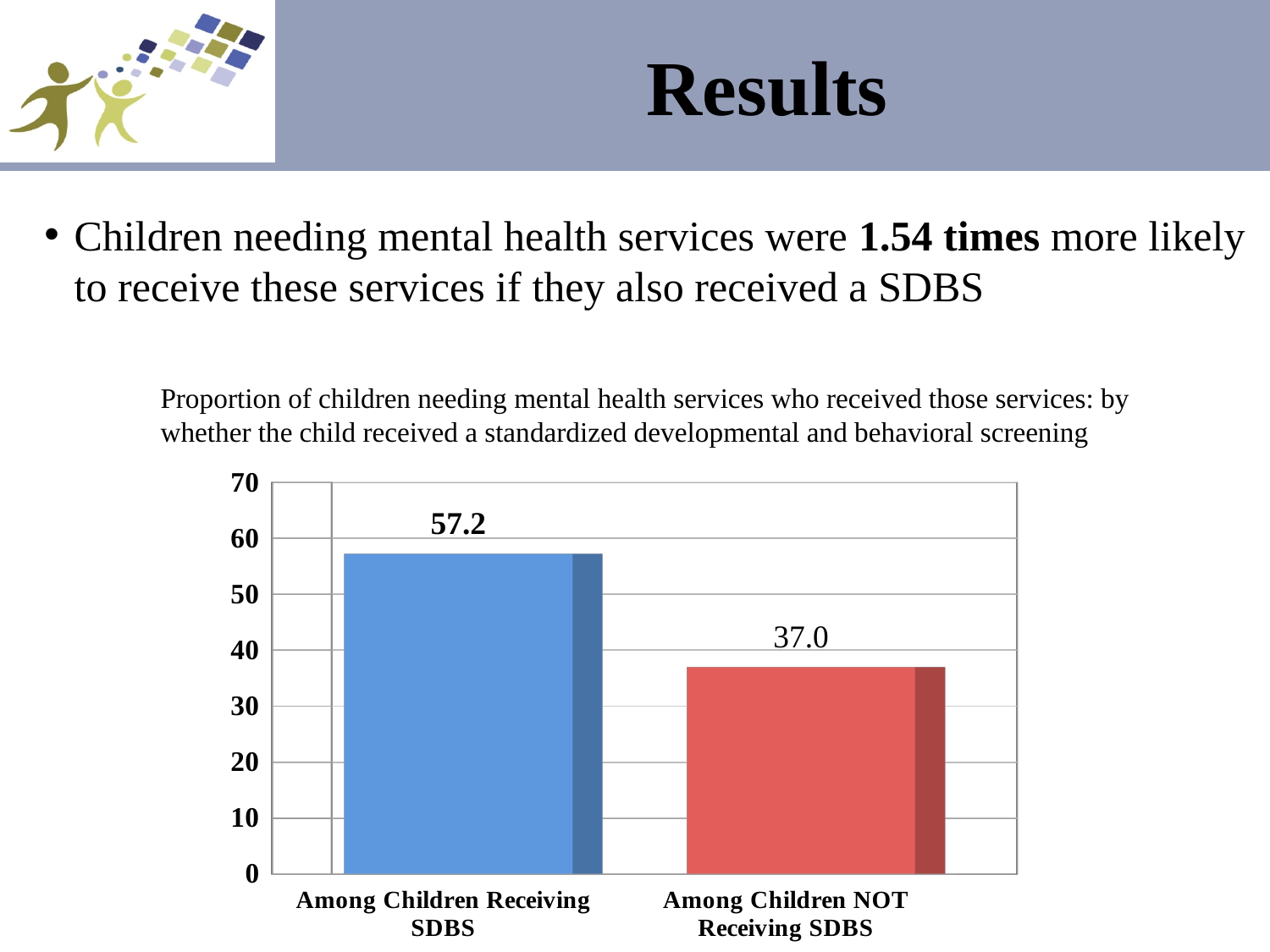
How many categories are shown on the chart? 2 Which category has the lowest value? Among Children NOT Receiving SDBS Is the value for Among Children NOT Receiving SDBS greater or less than 40? less Which is larger: the value for Among Children Receiving SDBS or the value for Among Children NOT Receiving SDBS? Among Children Receiving SDBS Is the value for Among Children Receiving SDBS greater or less than 50? greater What is the value for Among Children NOT Receiving SDBS? 37.0 Which category has the highest value? Among Children Receiving SDBS What kind of chart is shown on the slide? bar chart What is the maximum value shown on the vertical axis? 70 What colour is the bar for Among Children NOT Receiving SDBS? red What is the difference between the value for Among Children Receiving SDBS and the value for Among Children NOT Receiving SDBS? 20.2 What is the value for Among Children Receiving SDBS? 57.2